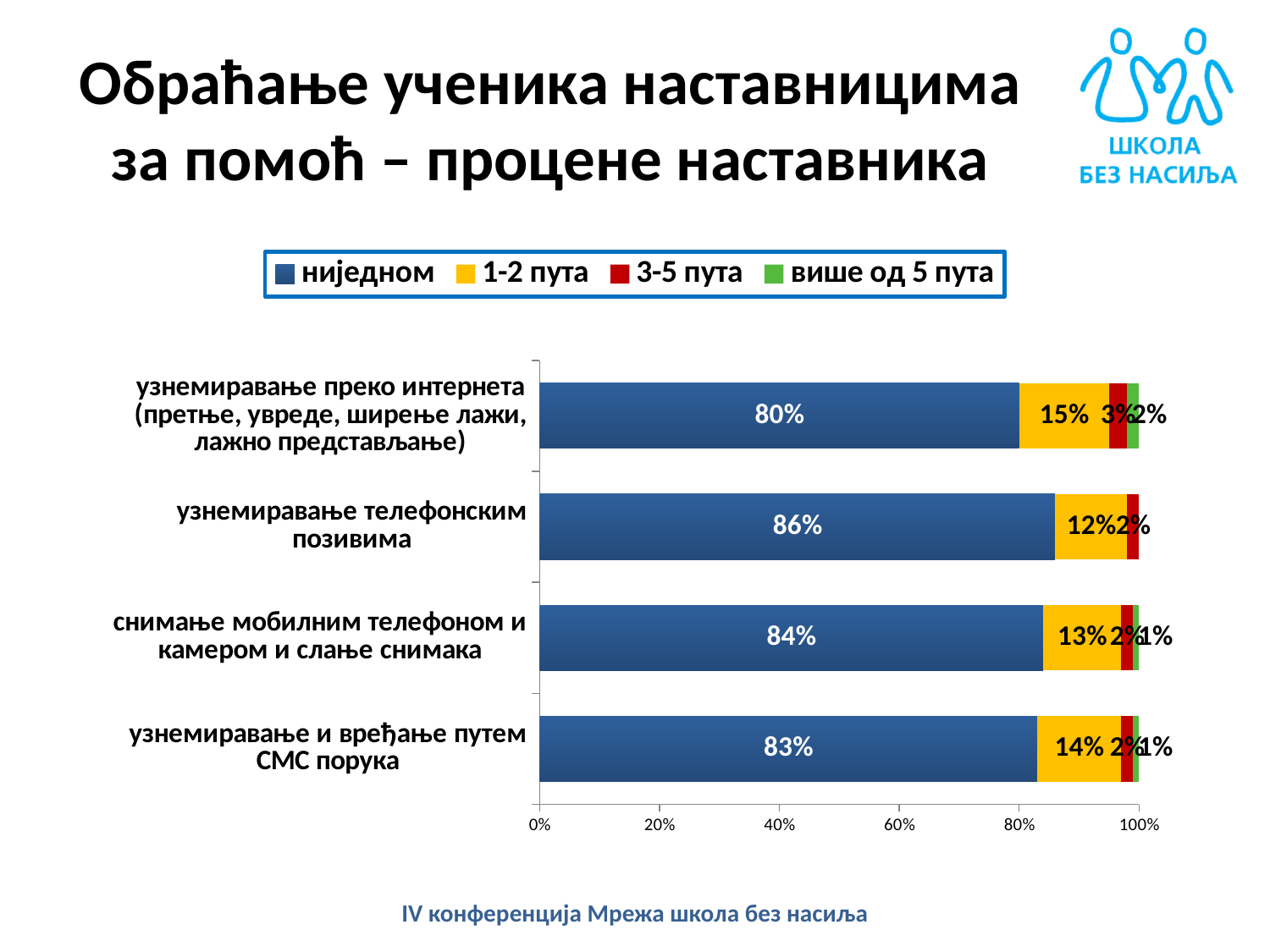
What is the difference between the 'ниједном' values for 'узнемиравање телефонским позивима' and 'узнемиравање преко интернета (претње, увреде, ширење лажи, лажно представљање)'? 6% What kind of chart is shown on the slide? stacked bar chart Which legend entry is shown in yellow? 1-2 пута Which category has the lowest 'ниједном' value? узнемиравање преко интернета (претње, увреде, ширење лажи, лажно представљање) What is the value of '1-2 пута' for 'снимање мобилним телефоном и камером и слање снимака'? 13% What is the value of 'ниједном' for 'узнемиравање и вређање путем СМС порука'? 83% What is the value of 'ниједном' for 'узнемиравање телефонским позивима'? 86% How many categories are plotted on the chart? 4 What is the value of '1-2 пута' for 'узнемиравање преко интернета (претње, увреде, ширење лажи, лажно представљање)'? 15% Which category has the highest 'ниједном' value? узнемиравање телефонским позивима How many series does the legend list? 4 Which is larger: the '1-2 пута' value for 'узнемиравање и вређање путем СМС порука' or for 'узнемиравање телефонским позивима'? узнемиравање и вређање путем СМС порука